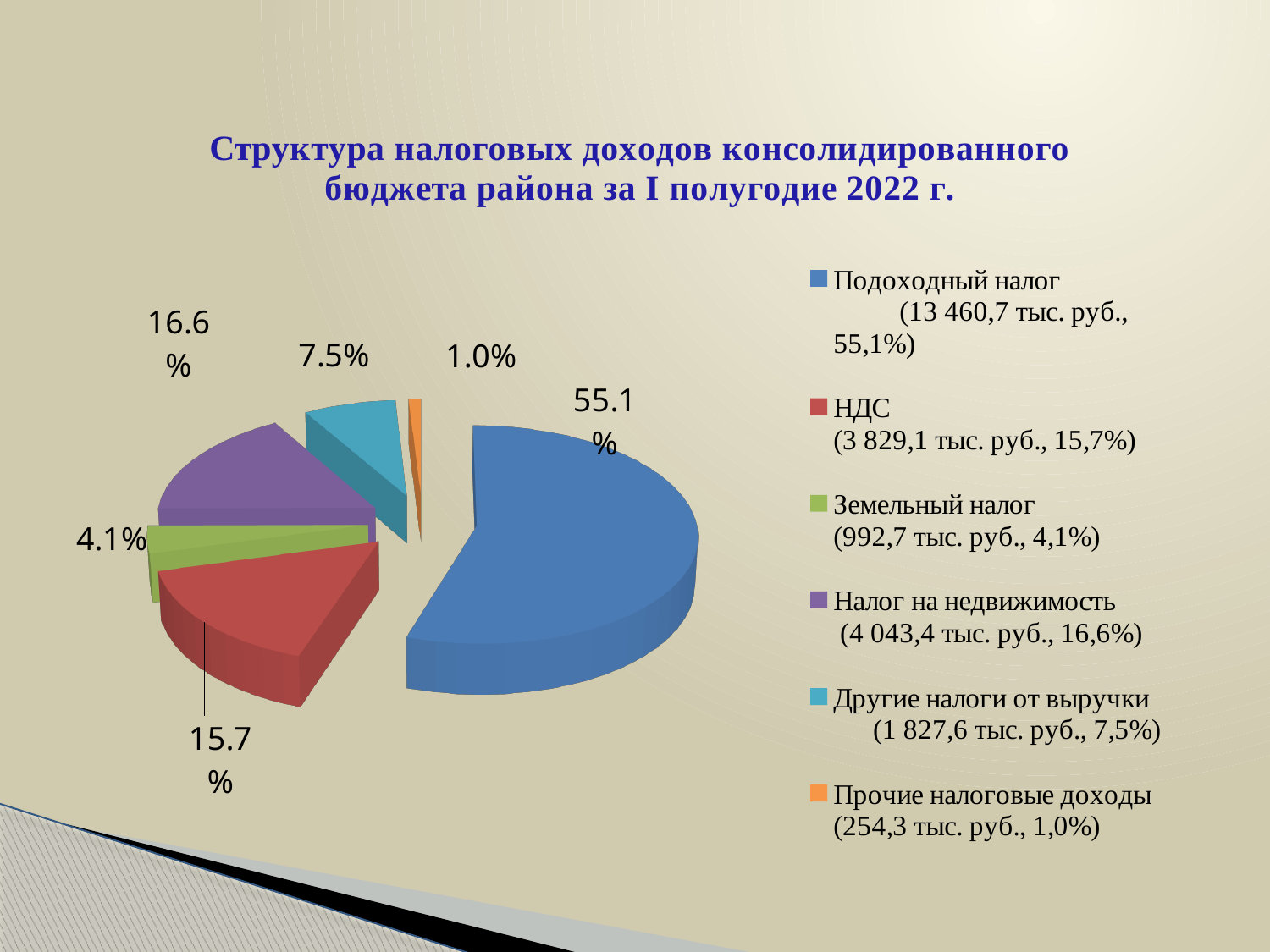
According to the legend, what amount in тыс. руб. is given for Другие налоги от выручки? 1 827,6 тыс. руб. Which category has the smallest slice of the pie? Прочие налоговые доходы What is the difference in percentage points between the share for Подоходный налог and the share for НДС? 39.4 How many slices does the pie chart have? 6 Which is larger, the share for НДС or the share for Налог на недвижимость? Налог на недвижимость What share of the pie does Налог на недвижимость have? 16.6% What share of the pie does Подоходный налог have? 55.1% What kind of chart is shown on the slide? pie chart What is the title of the chart? Структура налоговых доходов консолидированного бюджета района за I полугодие 2022 г. What share of the pie does НДС have? 15.7% Which category has the largest slice of the pie? Подоходный налог